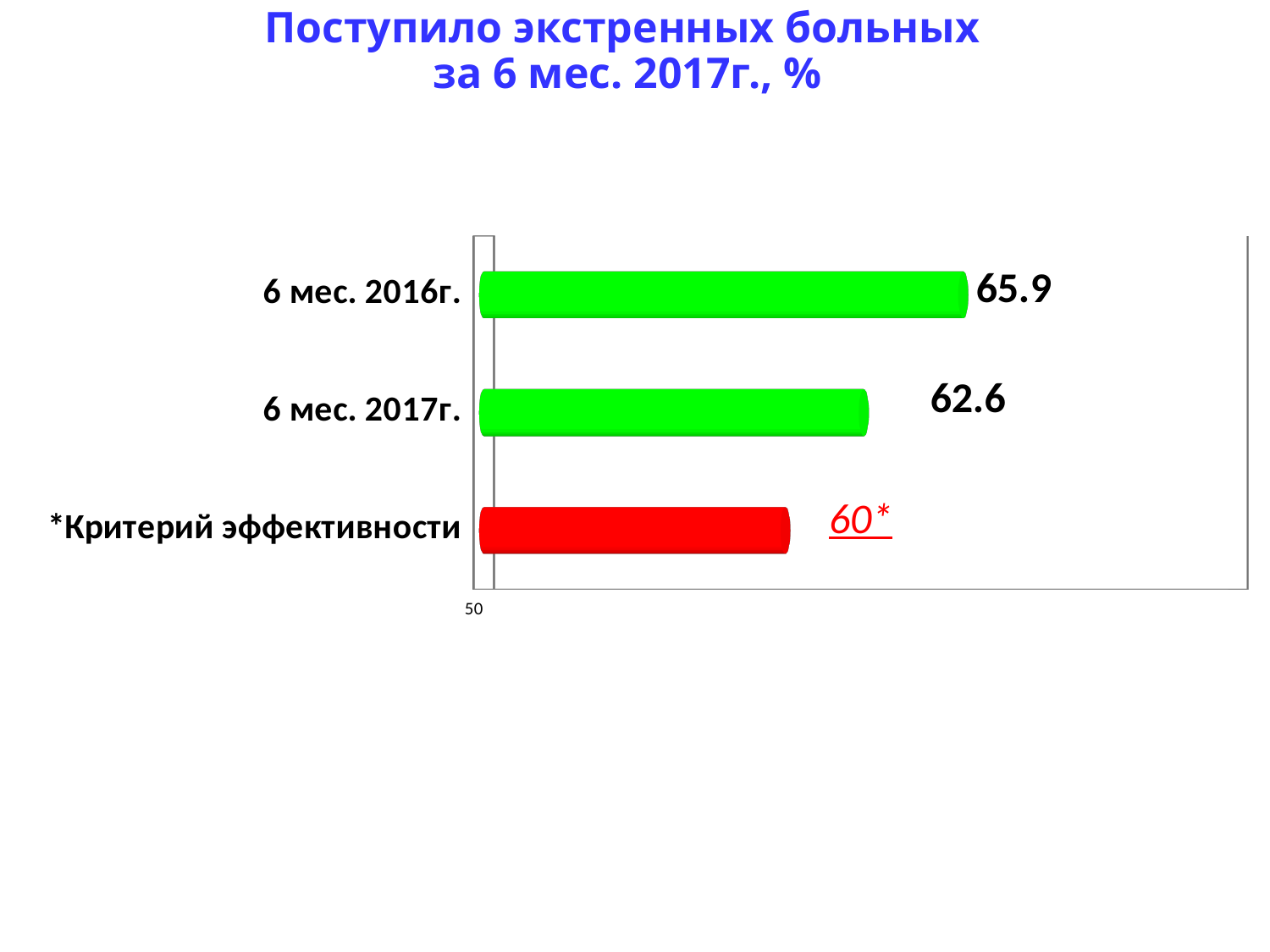
What is the value for 6 мес. 2017г.? 62.6 What is the value shown for *Критерий эффективности? 60* What is the difference between the value for 6 мес. 2017г. and the *Критерий эффективности value? 2.6 Which category has the lowest value? *Критерий эффективности What colour is the bar for *Критерий эффективности? red What is the value for 6 мес. 2016г.? 65.9 Which is larger, the value for 6 мес. 2016г. or for 6 мес. 2017г.? 6 мес. 2016г. What is the difference between the values for 6 мес. 2016г. and 6 мес. 2017г.? 3.3 Is the value for 6 мес. 2017г. greater or less than 50? greater What kind of chart is shown on the slide? bar chart Which category has the highest value? 6 мес. 2016г. How many bars are shown in the chart? 3